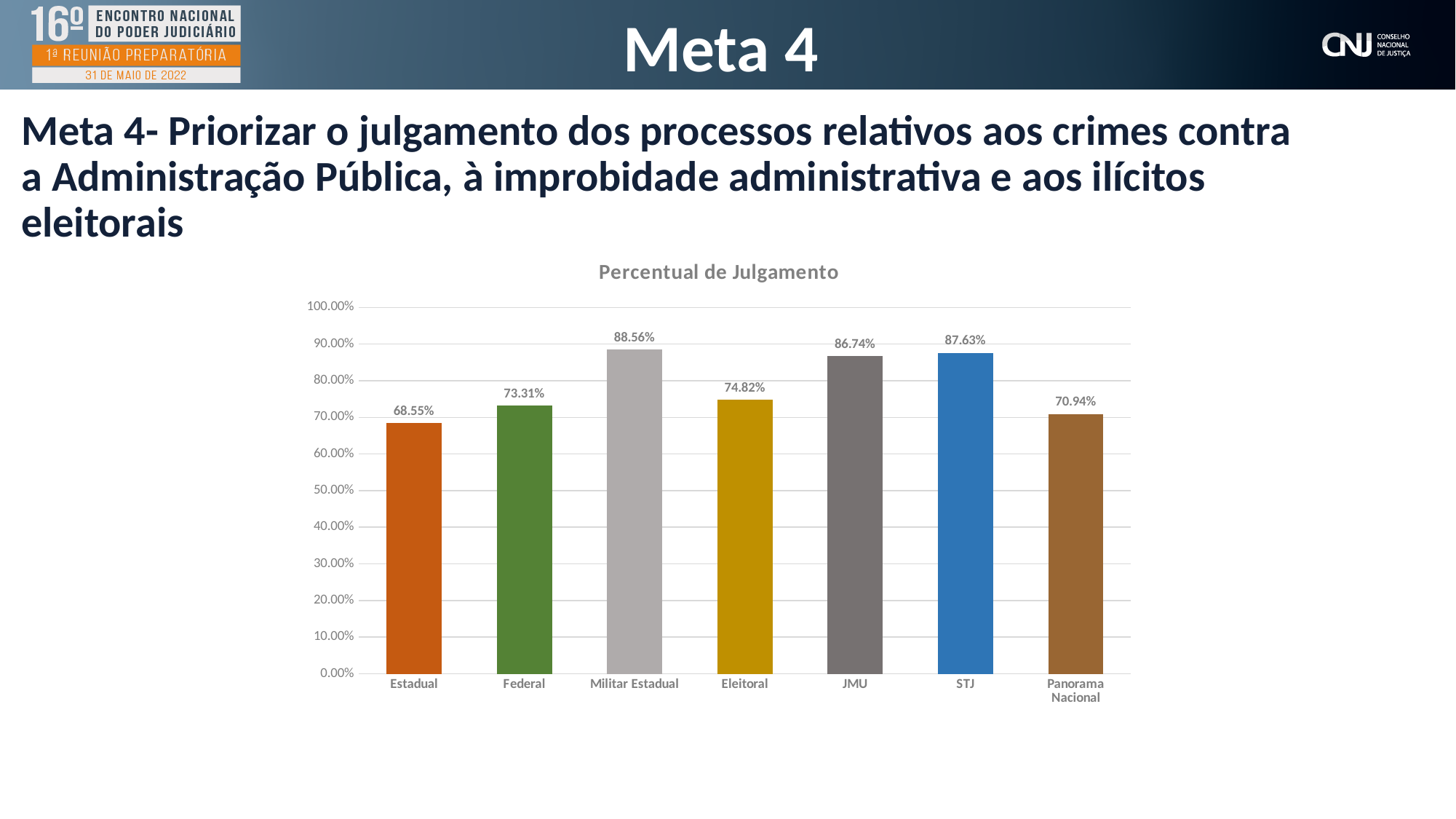
How many categories are shown in the Percentual de Julgamento chart? 7 What kind of chart is the Percentual de Julgamento chart? Bar chart What is the value for Militar Estadual in the Percentual de Julgamento chart? 88.56% Which category has the highest value in the Percentual de Julgamento chart? Militar Estadual Which category has the lowest value in the Percentual de Julgamento chart? Estadual What is the difference between the values for Militar Estadual and Estadual in the Percentual de Julgamento chart? 20.01 percentage points What is the difference between the values for Eleitoral and Federal in the Percentual de Julgamento chart? 1.51 percentage points Is the value for STJ in the Percentual de Julgamento chart greater or less than 80.00%? greater What is the title of the chart on the slide? Percentual de Julgamento What is the value for JMU in the Percentual de Julgamento chart? 86.74% What is the value for Panorama Nacional in the Percentual de Julgamento chart? 70.94% Which is larger in the Percentual de Julgamento chart, the value for Federal or the value for Panorama Nacional? Federal